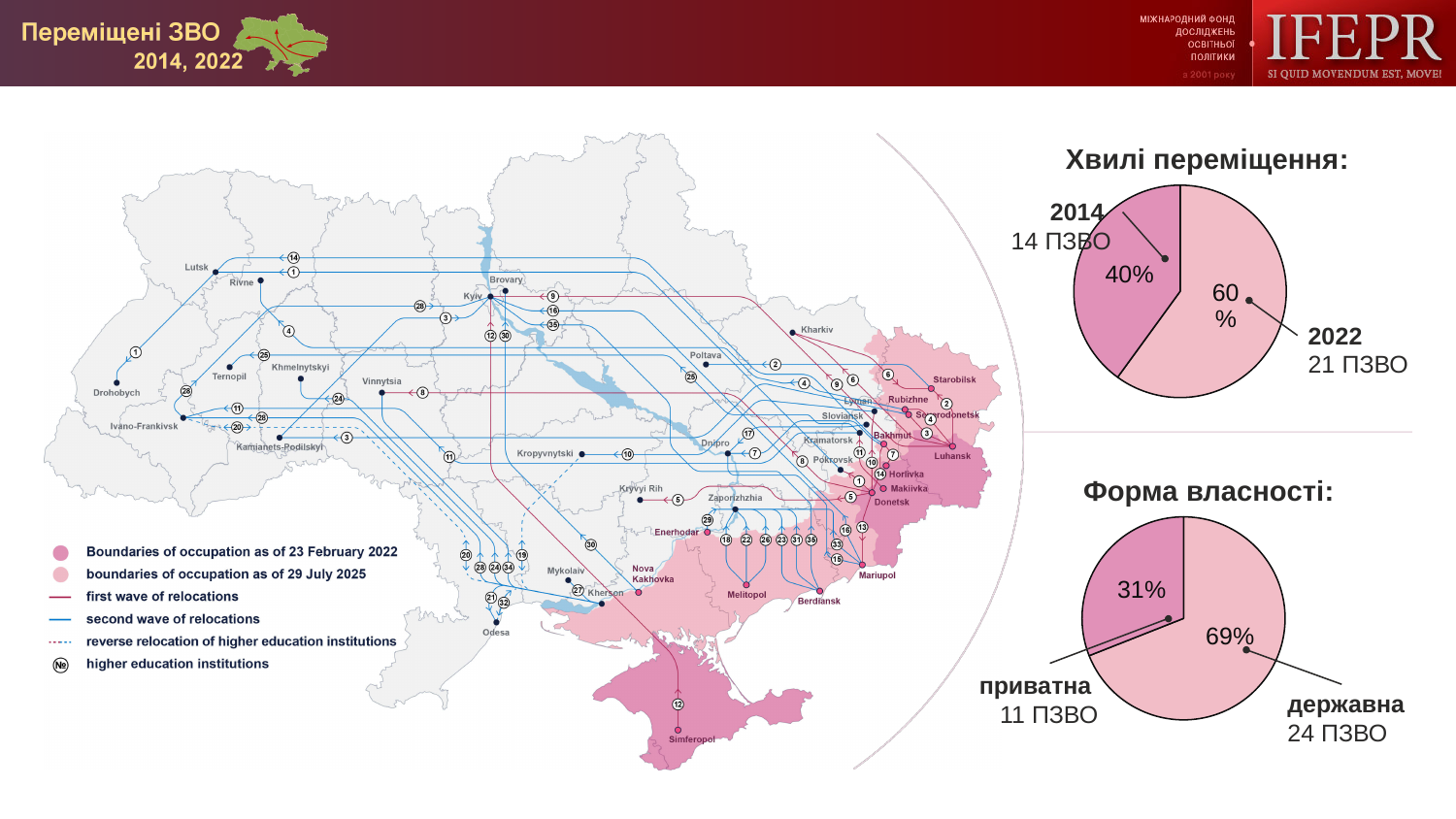
In the 'Хвилі переміщення' chart, how many ПЗВО are shown for 2014? 14 ПЗВО In the 'Форма власності' chart, which category has the smaller slice? приватна In the 'Форма власності' chart, how many ПЗВО are приватна? 11 ПЗВО In the 'Хвилі переміщення' chart, which year has the larger slice? 2022 In the 'Хвилі переміщення' chart, what share of the pie does 2014 account for? 40% In the 'Хвилі переміщення' chart, what is the difference in ПЗВО count between 2022 and 2014? 7 In the 'Хвилі переміщення' chart, what share of the pie does 2022 account for? 60% In the 'Хвилі переміщення' chart, how many ПЗВО are shown for 2022? 21 ПЗВО In the 'Форма власності' chart, what share of the pie is приватна? 31% In the 'Форма власності' chart, how many ПЗВО are державна? 24 ПЗВО What type of chart is used for 'Форма власності'? Pie chart